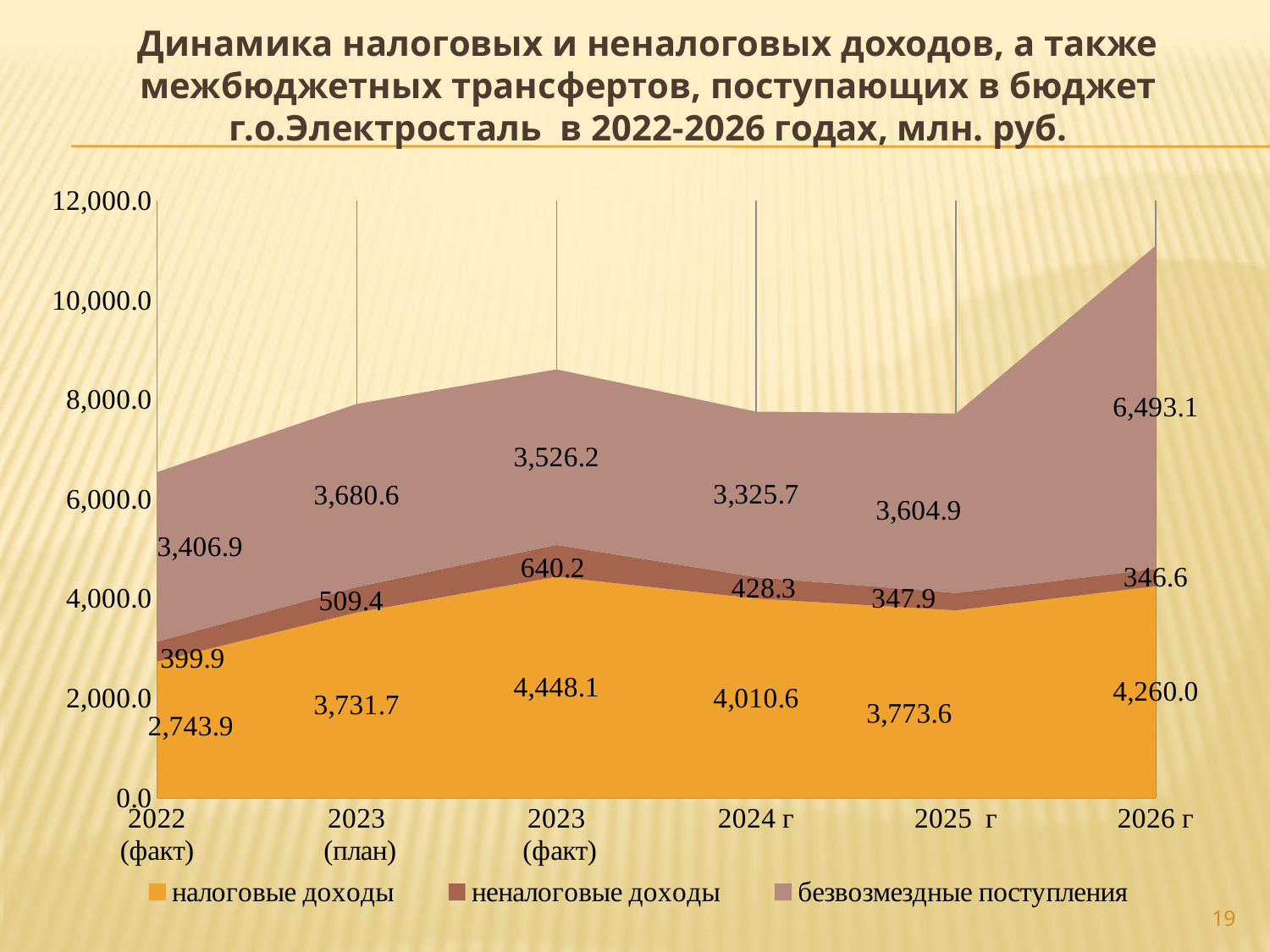
What kind of chart is shown on the slide? Stacked area chart In which category is налоговые доходы lowest? 2022 (факт) What is the total of all three series for 2026 г? 11,099.7 Which is larger: налоговые доходы in 2024 г or in 2025 г? 2024 г How many series does the legend list? 3 In which category is неналоговые доходы highest? 2023 (факт) What is the difference between налоговые доходы in 2023 (факт) and in 2022 (факт)? 1,704.2 In which category is безвозмездные поступления highest? 2026 г What is the value of неналоговые доходы for 2024 г? 428.3 What is the value of налоговые доходы for 2023 (факт)? 4,448.1 What is the value of безвозмездные поступления for 2026 г? 6,493.1 How many categories are shown on the x axis? 6